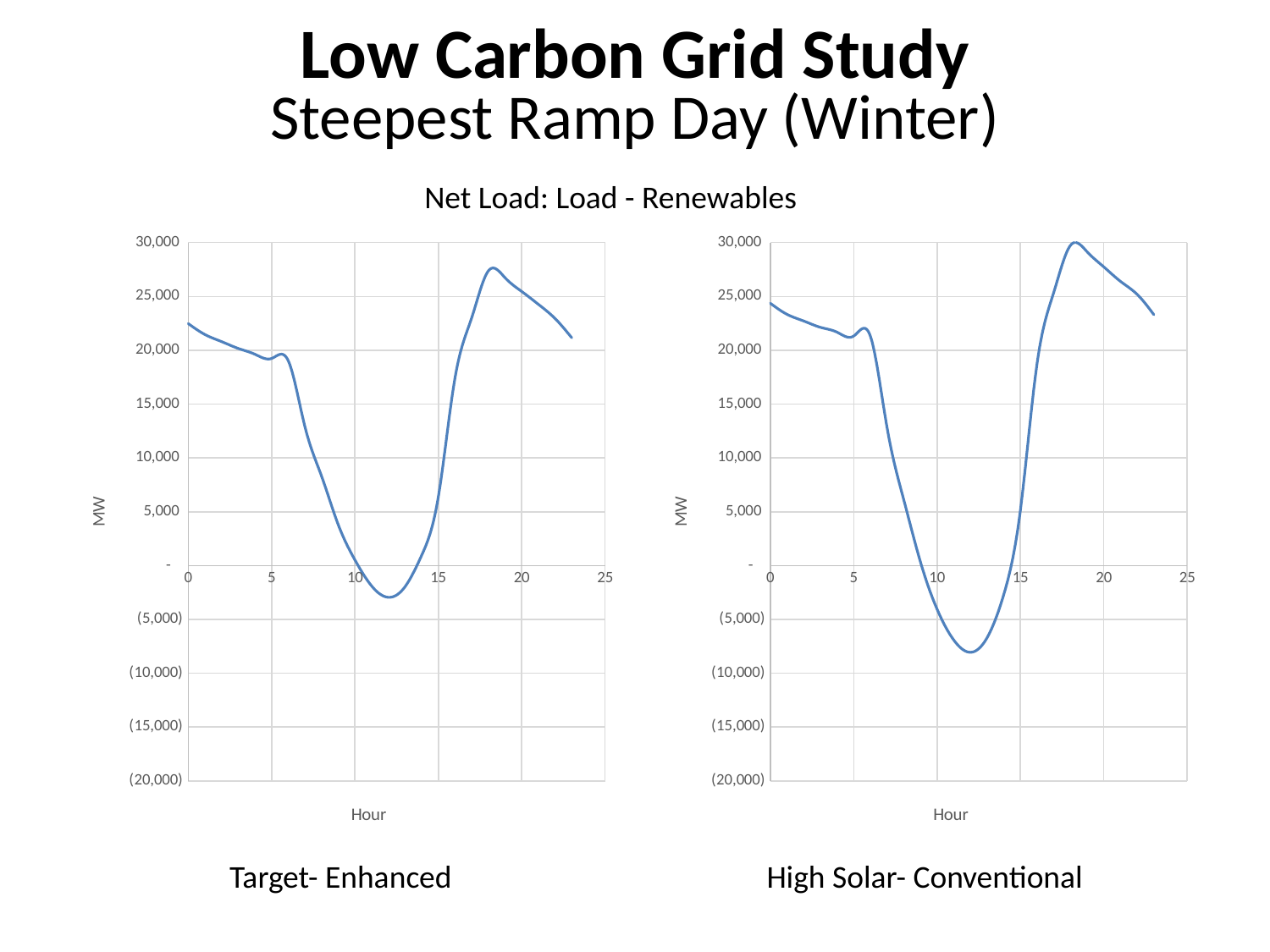
In the High Solar- Conventional chart, is the value at hour 10 greater or less than 0? less What is the shared title above the two charts? Net Load: Load - Renewables In the High Solar- Conventional chart, does the net load rise or fall between hour 12 and hour 18? rise In the Target- Enhanced chart, is the value at hour 12 greater or less than 0? less What is the label on the vertical axis of the Target- Enhanced chart? MW In the Target- Enhanced chart, does the net load rise or fall between hour 6 and hour 12? fall In the Target- Enhanced chart, is the value at hour 18 greater or less than 25,000? greater What kind of chart is the Target- Enhanced chart on the left? line chart Which chart reaches the lower minimum net load, Target- Enhanced or High Solar- Conventional? High Solar- Conventional